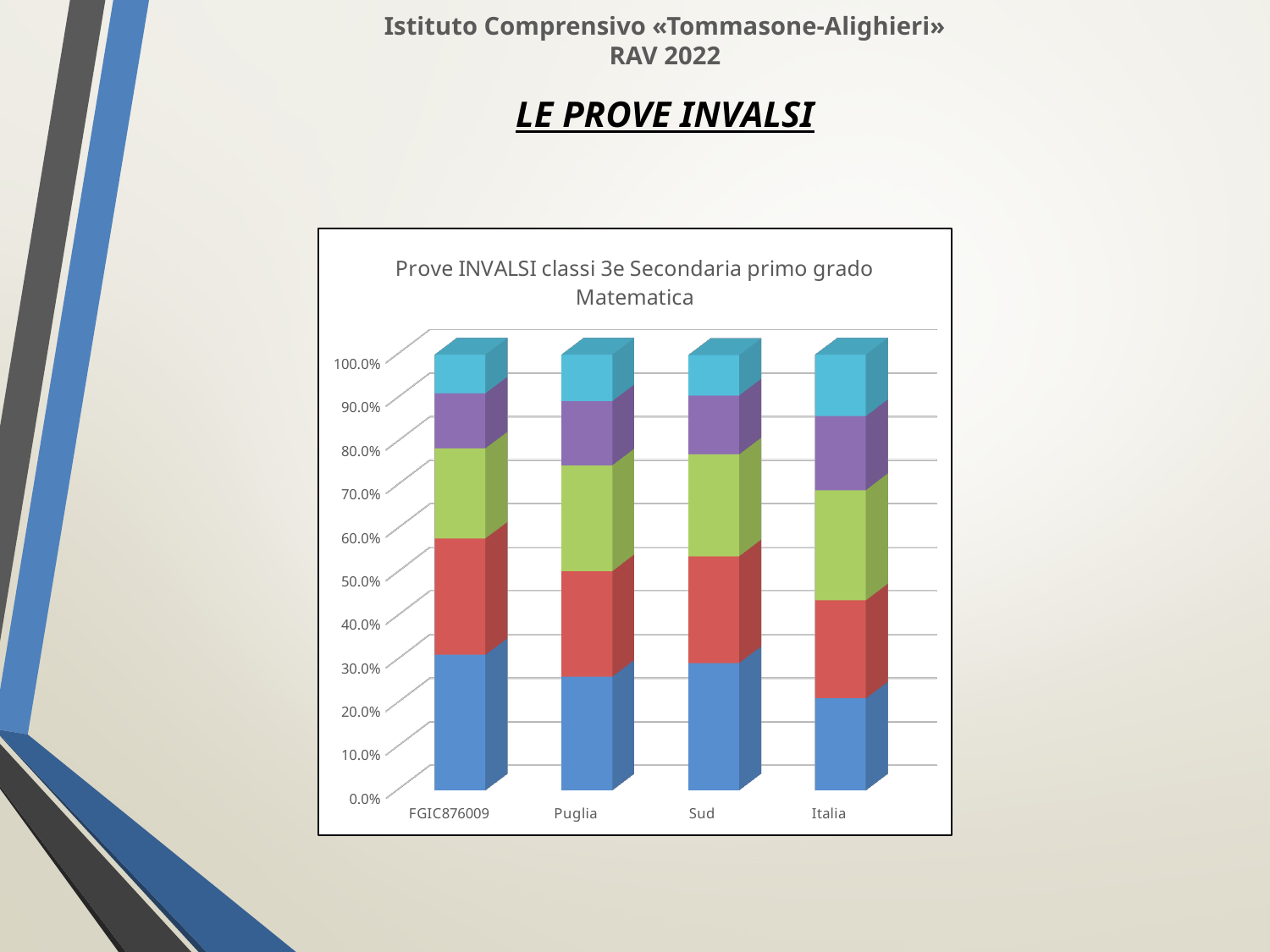
How many coloured segments make up each stacked bar in the chart? 5 Which bar has the larger bottom (blue) segment, FGIC876009 or Italia? FGIC876009 What is the title of the chart? Prove INVALSI classi 3e Secondaria primo grado Matematica What is the total height of the stacked bar for FGIC876009? 100.0% Is the bottom (blue) segment of the FGIC876009 bar greater or less than 20.0%? greater What kind of chart is shown on the slide? stacked bar chart What is the total height of the stacked bar for Italia? 100.0% How many categories are shown on the x axis of the chart? 4 Which category has the smallest bottom (blue) segment? Italia What is the highest value shown on the vertical axis of the chart? 100.0% Which category is listed first on the x axis of the chart? FGIC876009 Is the bottom (blue) segment of the Italia bar greater or less than 30.0%? less